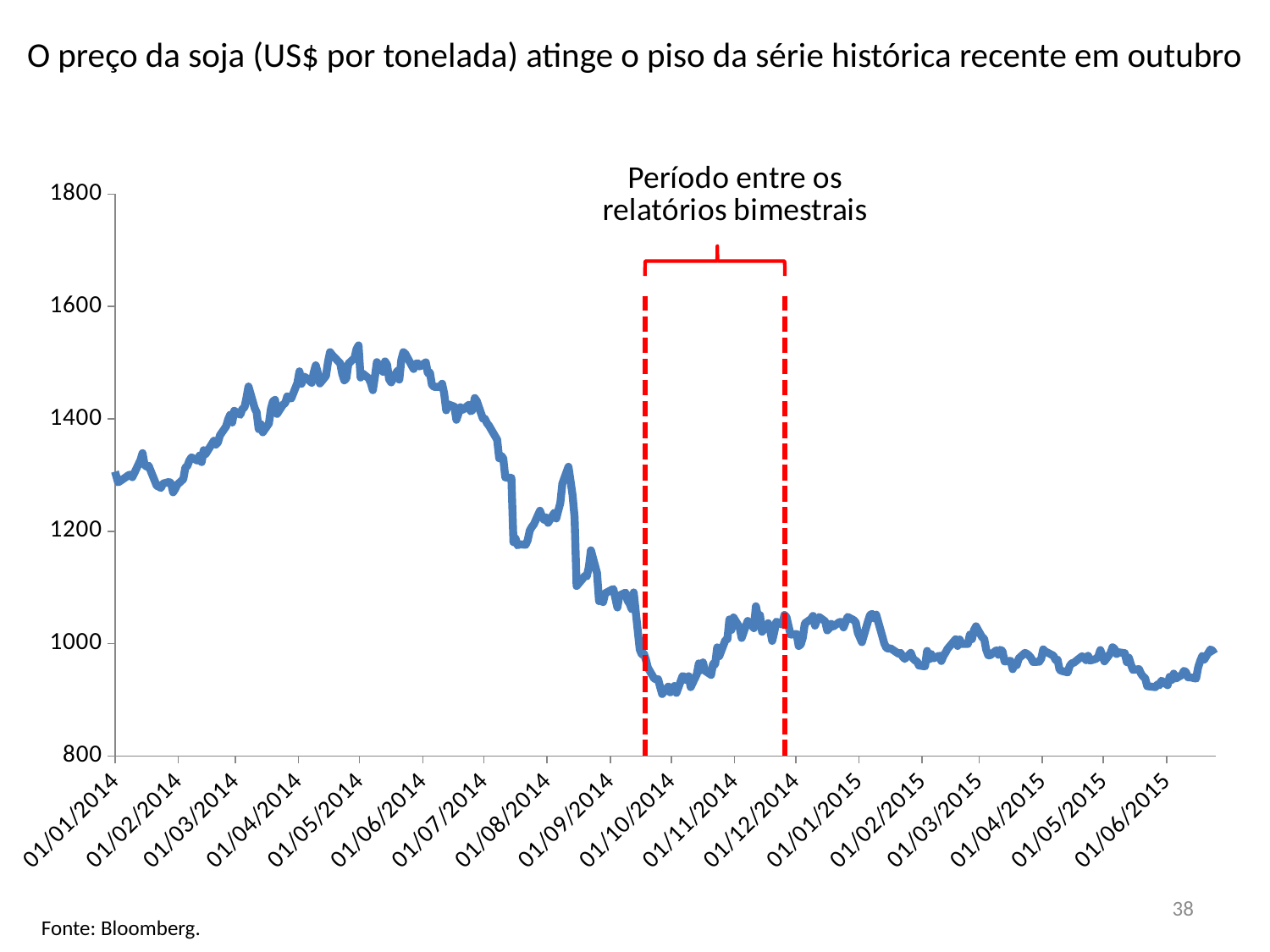
What source is cited for the chart? Bloomberg How many date labels are shown on the x axis? 18 Is the soybean price at 01/01/2014 greater or less than 1200? greater Does the soybean price rise or fall between 01/05/2014 and 01/10/2014? fall Is the soybean price at 01/05/2014 greater or less than 1400? greater Is the soybean price at 01/10/2014 greater or less than 1000? less Is the soybean price higher at 01/05/2014 or at 01/01/2015? 01/05/2014 What kind of chart is shown on the slide? line chart What is the title of the chart on the slide? O preço da soja (US$ por tonelada) atinge o piso da série histórica recente em outubro Does the soybean price rise or fall between 01/01/2014 and 01/05/2014? rise